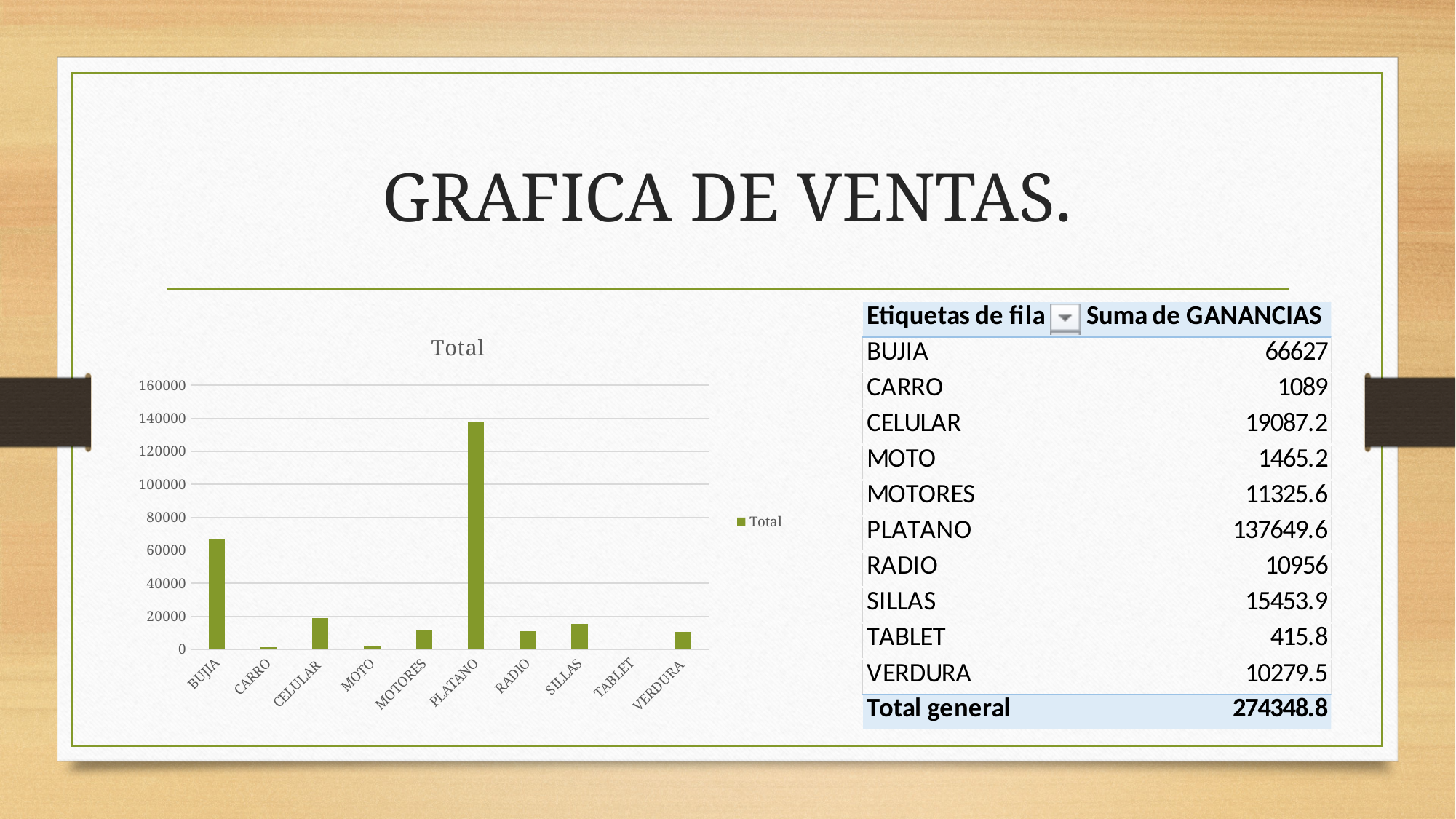
What kind of chart is shown on the slide? bar chart Is the value for BUJIA greater or less than 80000? less According to the table on the slide, what is the Total general of GANANCIAS? 274348.8 Which category has the lowest value in the chart? TABLET What is the title of the chart? Total How many series does the chart legend list? 1 Which is larger, the value for CELULAR or the value for SILLAS? CELULAR Is the value for PLATANO greater or less than 120000? greater Which category has the highest bar in the chart? PLATANO According to the table on the slide, what is the Suma de GANANCIAS for PLATANO? 137649.6 How many categories are shown on the x axis of the chart? 10 According to the table on the slide, what is the Suma de GANANCIAS for BUJIA? 66627